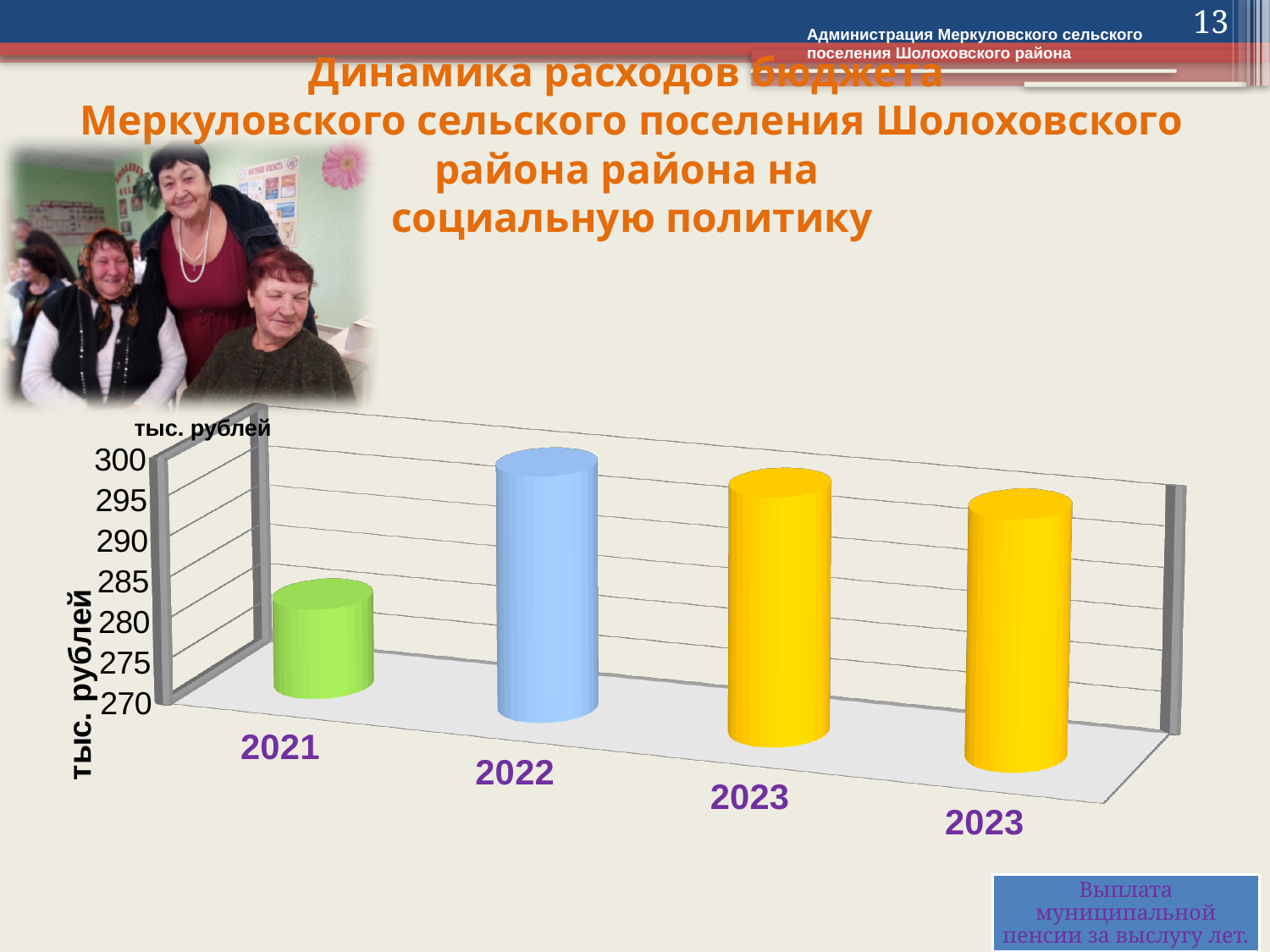
What unit is shown on the vertical axis of the chart? тыс. рублей What kind of chart is shown on the slide? bar chart How many bars are plotted in the chart? 4 Is the value for 2021 greater or less than 290? less Does the value rise or fall from 2021 to 2022? rise Which year has the lowest value in the chart? 2021 Which is larger, the value for 2021 or the value for 2022? 2022 Is the value for 2022 greater or less than 290? greater What colour is the bar for 2021? green